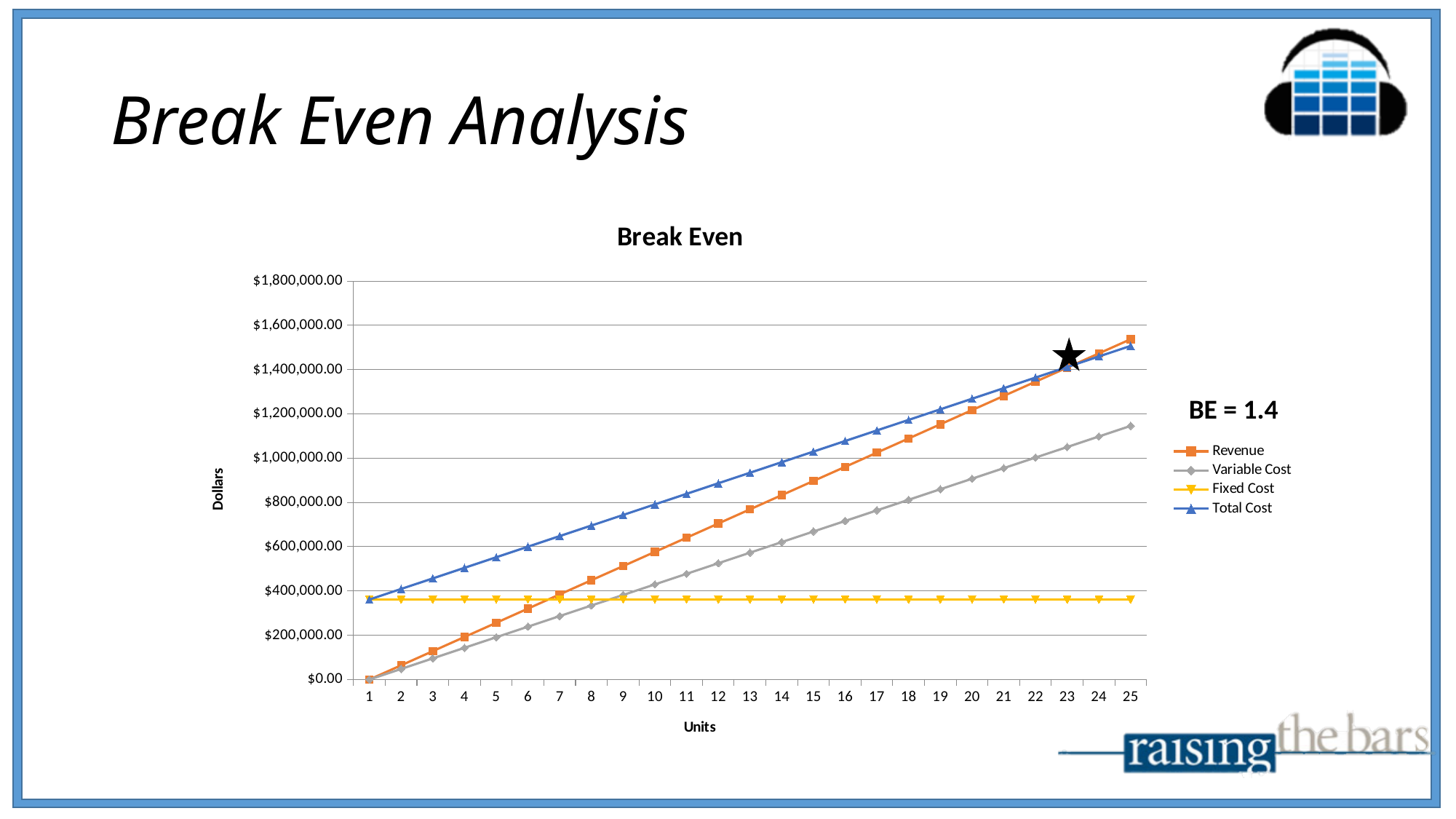
Is the Revenue value at unit 25 greater or less than $1,400,000.00? greater How many units are plotted along the x axis? 25 Is the Total Cost value at unit 20 greater or less than $1,200,000.00? greater Does the Revenue series rise, fall, or stay flat as units increase? rise At unit 10, which is larger: Total Cost or Revenue? Total Cost Is the Fixed Cost value at unit 10 greater or less than $400,000.00? less Which series has the lowest value at unit 25? Fixed Cost What is the title of the chart? Break Even How many series does the legend list? 4 What kind of chart is shown on the slide? line chart What is the Revenue value at unit 1? $0.00